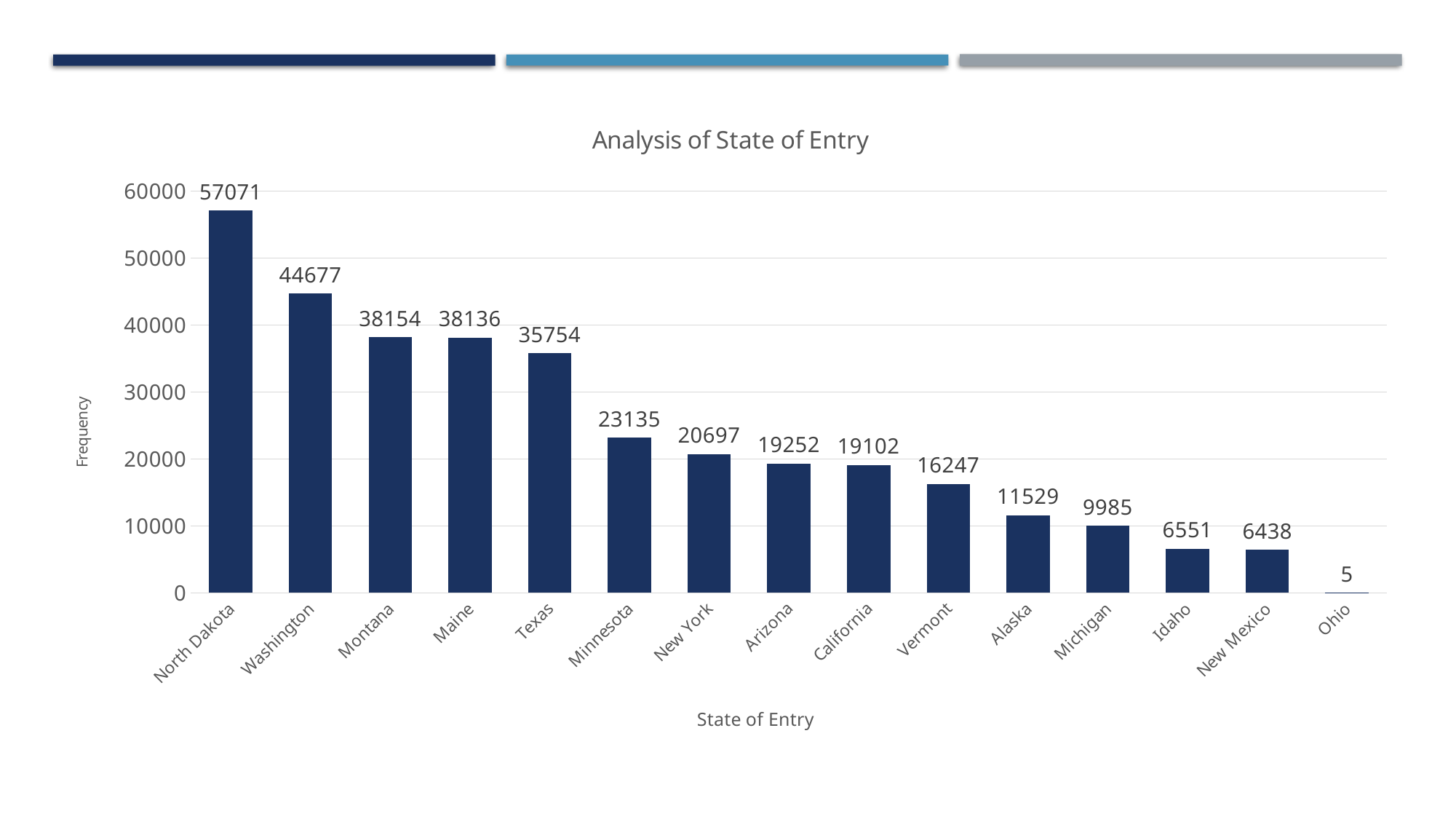
Which state of entry has the lowest frequency? Ohio How many states of entry are shown on the chart? 15 Which state of entry has the highest frequency? North Dakota What is the frequency for Washington? 44677 What is the frequency for Ohio? 5 Is the frequency for Alaska greater or less than 10000? greater What is the difference in frequency between North Dakota and Washington? 12394 What is the title of the chart? Analysis of State of Entry What is the frequency for Vermont? 16247 What kind of chart is shown on the slide? bar chart Which has a higher frequency, Texas or Minnesota? Texas What is the difference in frequency between Idaho and New Mexico? 113